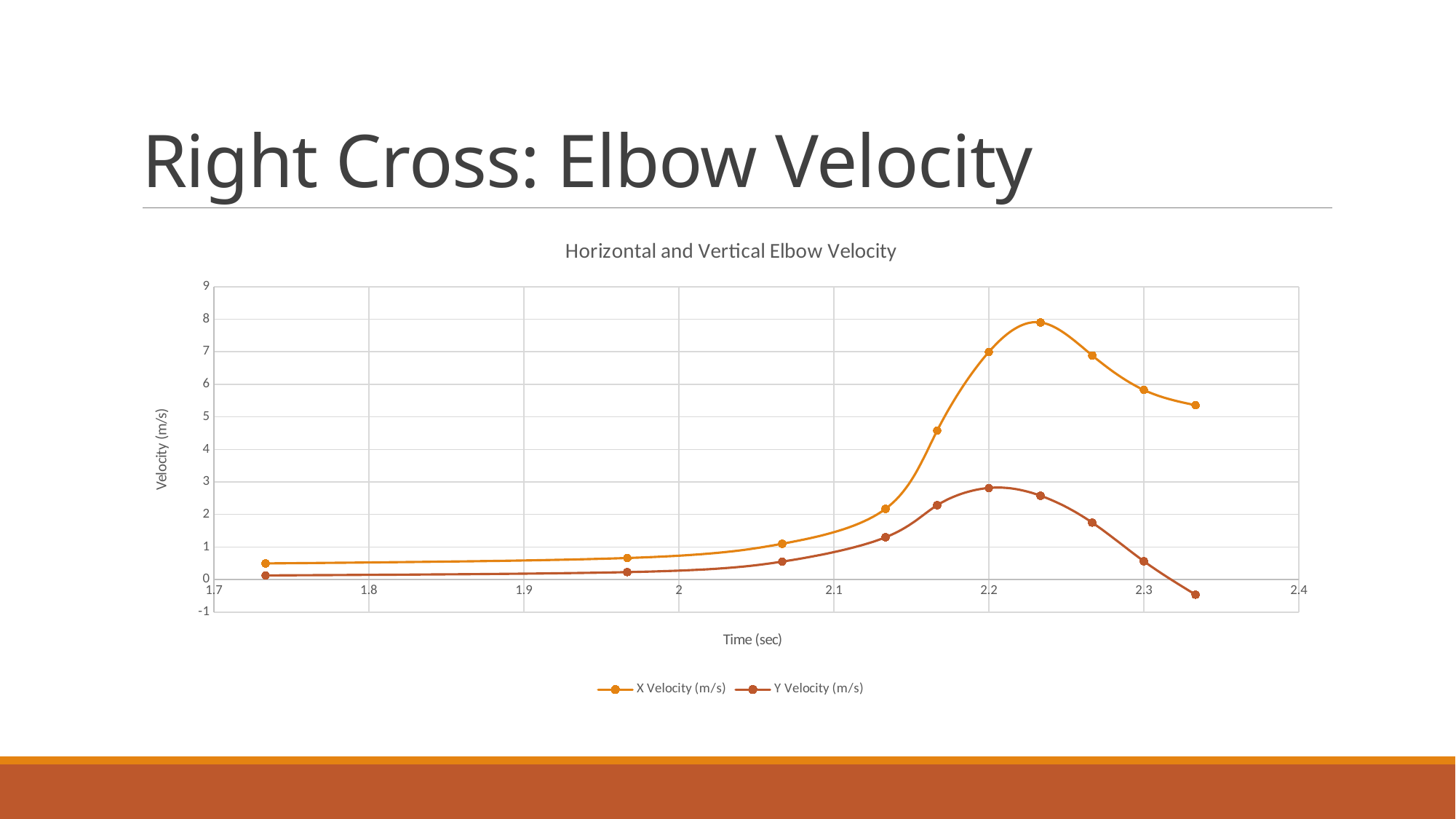
What is the label of the vertical axis? Velocity (m/s) How many data points are plotted for the X Velocity (m/s) series? 10 Is the peak value of the Y Velocity (m/s) series greater or less than 3? less At time 2.2 sec, which series has the larger value, X Velocity (m/s) or Y Velocity (m/s)? X Velocity (m/s) What kind of chart is shown on the slide? line chart Which series reaches the higher peak velocity, X Velocity (m/s) or Y Velocity (m/s)? X Velocity (m/s) What is the title of the chart? Horizontal and Vertical Elbow Velocity Is the last plotted value of the Y Velocity (m/s) series greater or less than 0? less Is the peak value of the X Velocity (m/s) series greater or less than 7? greater How many series does the legend list? 2 After reaching its peak, does the X Velocity (m/s) series rise or fall toward the end of the time axis? fall